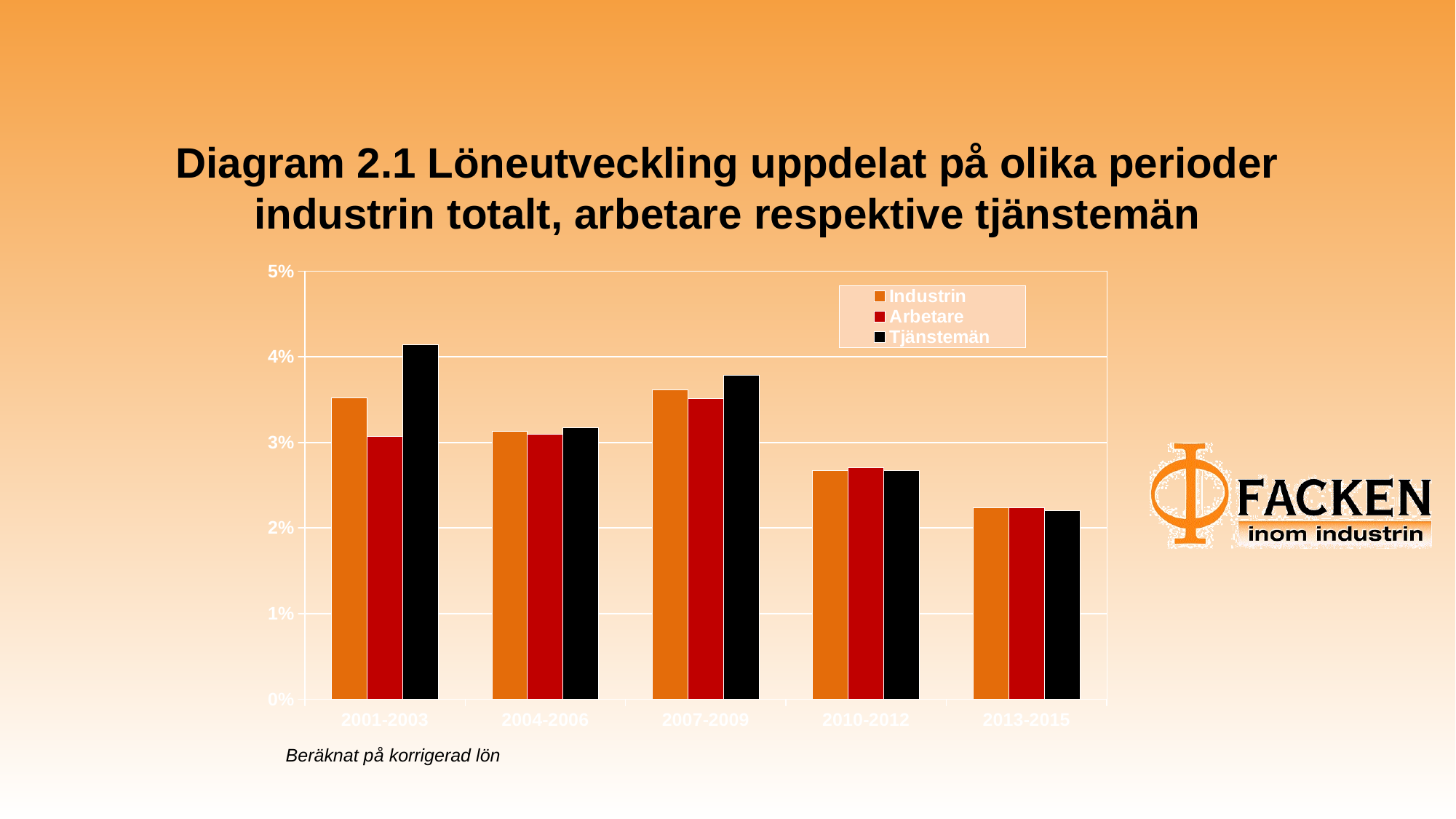
How many series does the chart's legend list? 3 Is the value for Industrin in 2007-2009 greater or less than 3%? greater How many periods are shown on the x axis of the chart? 5 In which period is the Tjänstemän value highest? 2001-2003 In 2001-2003, which is larger: the value for Tjänstemän or the value for Arbetare? Tjänstemän From 2007-2009 to 2013-2015, do the Industrin values rise or fall? fall Is the value for Tjänstemän in 2001-2003 greater or less than 4%? greater Which series is shown in black in the chart? Tjänstemän Is the value for Industrin in 2010-2012 greater or less than 3%? less What kind of chart is shown on the slide? bar chart In which period is the Industrin value lowest? 2013-2015